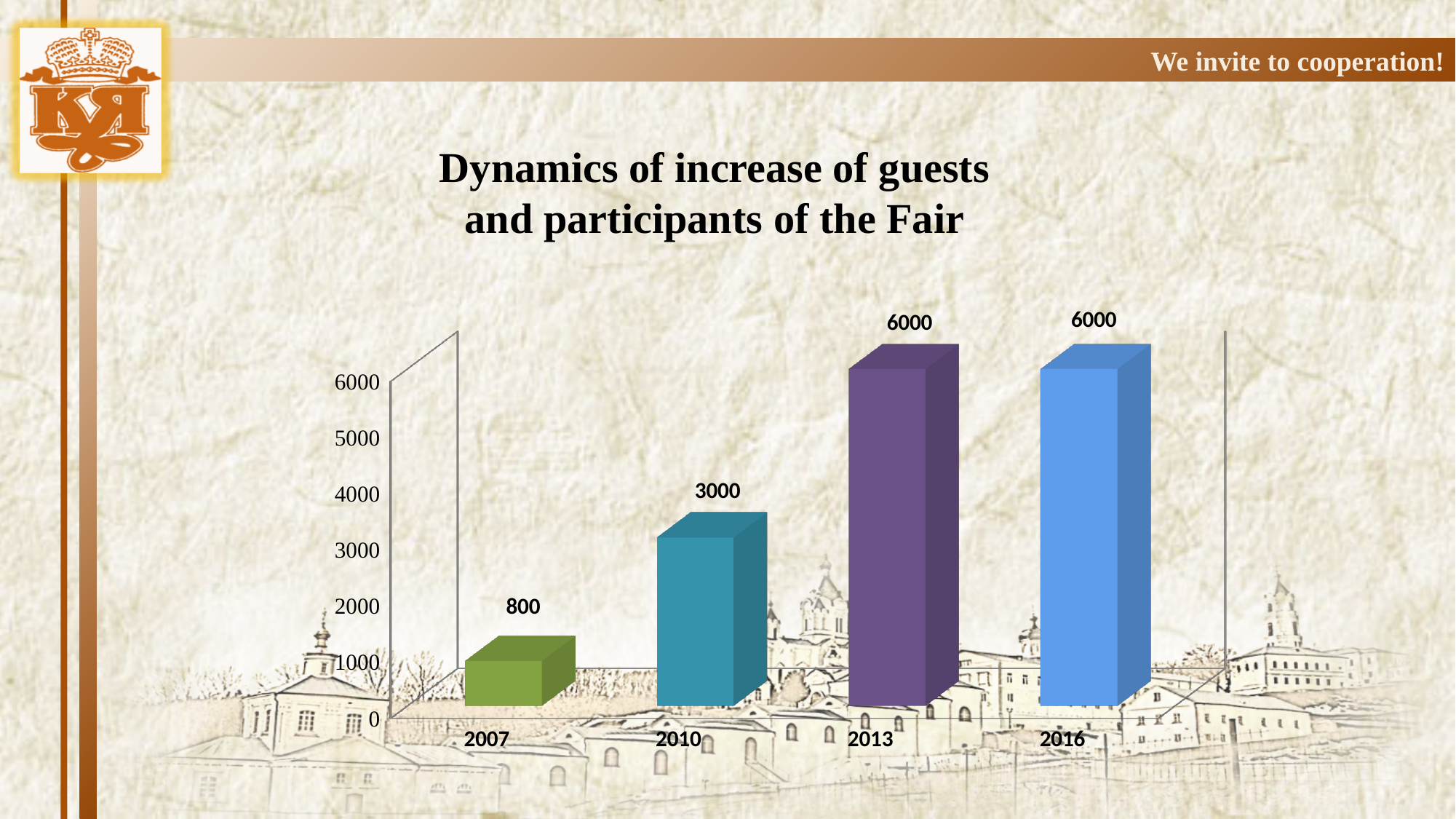
What kind of chart is shown on the slide? bar chart Do the values rise or fall from 2007 to 2013? rise What is the title of the chart? Dynamics of increase of guests and participants of the Fair What is the value for 2013? 6000 What is the value for 2010? 3000 How many years are shown on the x axis? 4 Which year has the lowest value? 2007 Which is larger, the value for 2010 or the value for 2007? 2010 What is the difference between the values for 2013 and 2010? 3000 What is the value for 2016? 6000 What is the difference between the values for 2010 and 2007? 2200 What is the value for 2007? 800